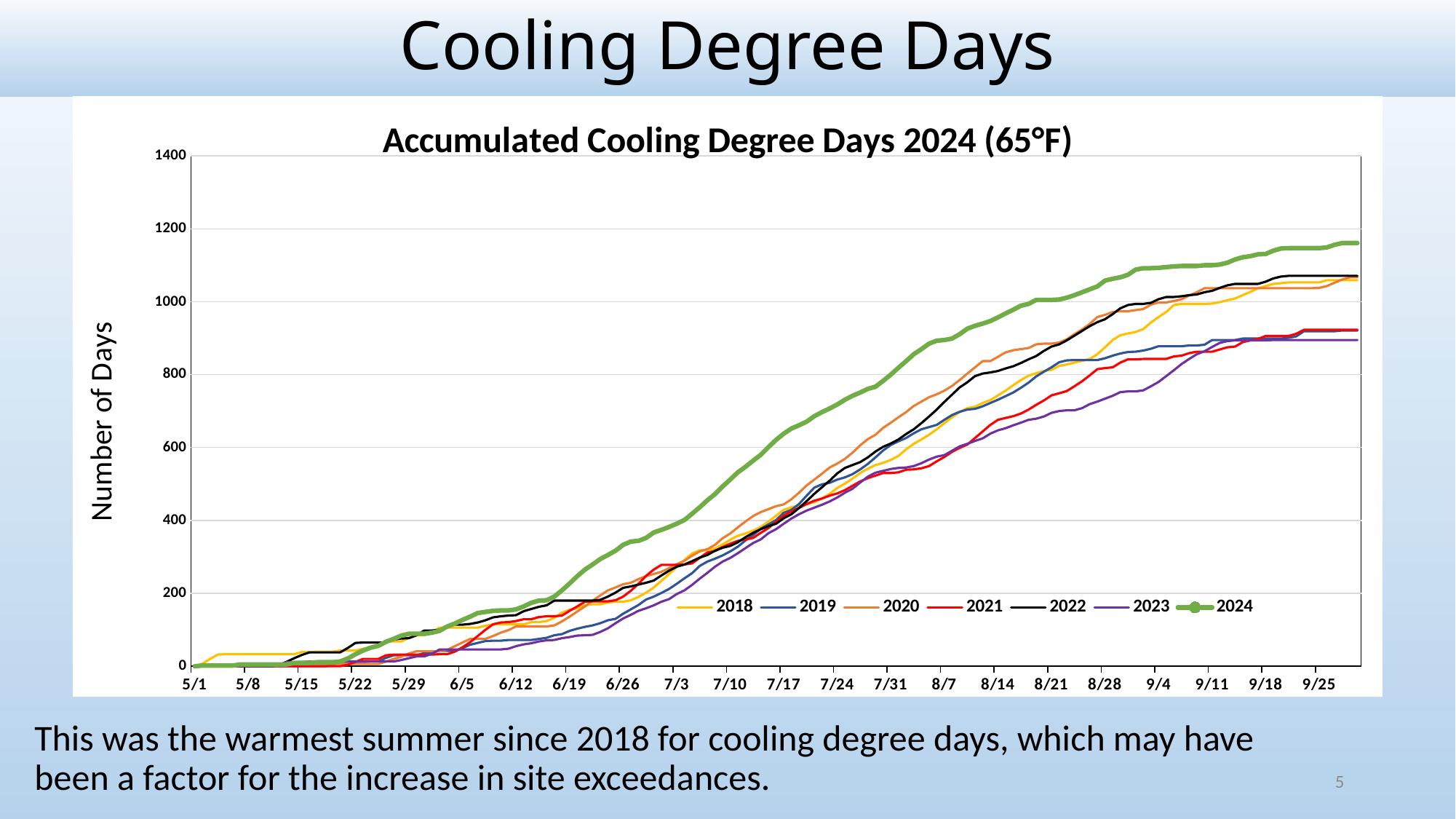
What kind of chart is shown on the slide? line chart Is the value of the 2024 series at 7/17 greater or less than 600? greater What is the title of the chart? Accumulated Cooling Degree Days 2024 (65°F) At the end of the period, which is larger: the 2024 series or the 2022 series? 2024 How many series does the legend list? 7 Which series reaches the highest value at the end of the period (late September)? 2024 At 8/7, which is larger: the 2024 series or the 2023 series? 2024 Is the value of the 2023 series at 7/17 greater or less than 600? less Is the final value of the 2023 series greater or less than 1000? less What is the label on the vertical axis? Number of Days Do the series values rise or fall from 5/1 to 9/25? rise